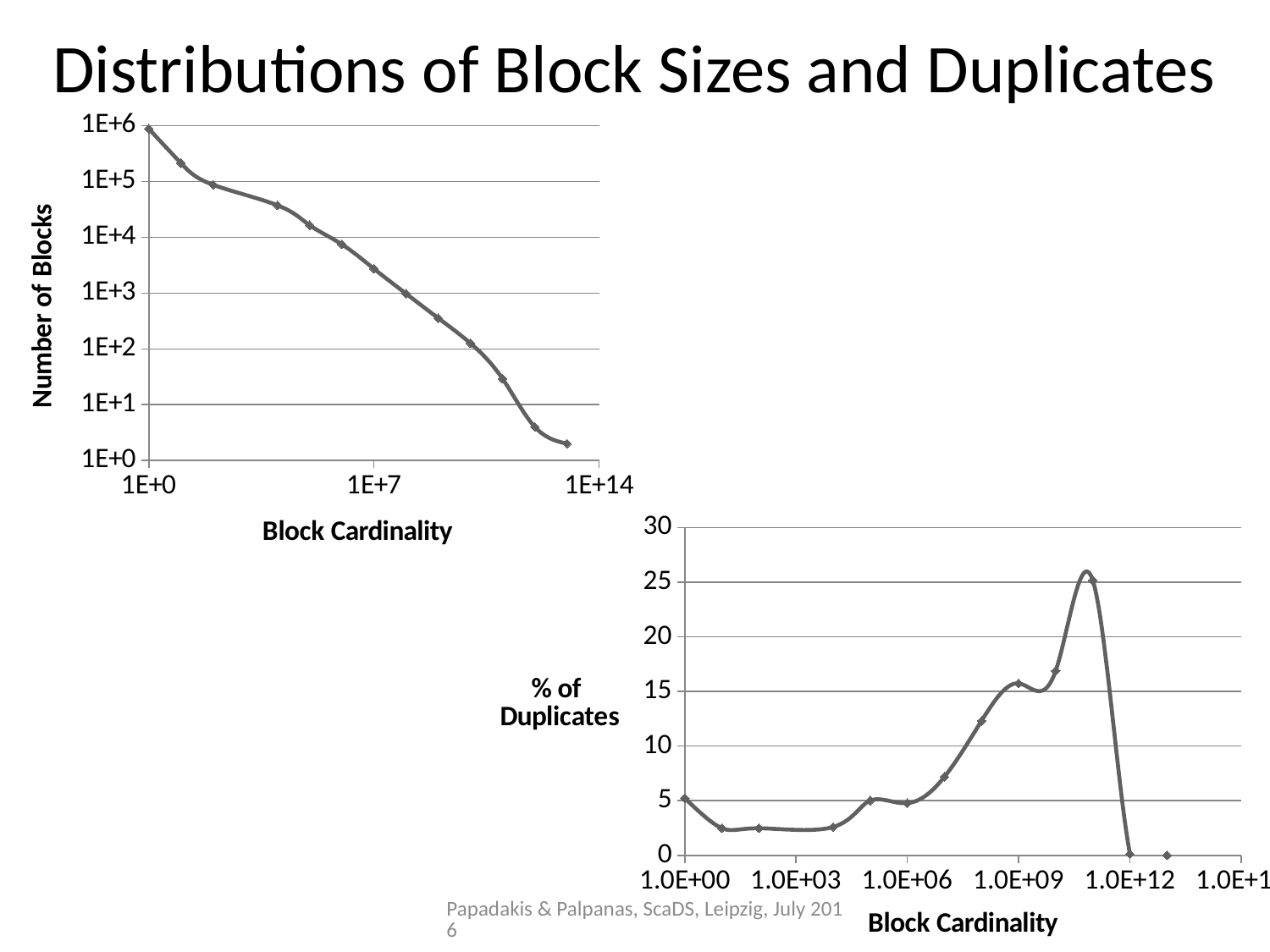
In the top-left chart, is the Number of Blocks at Block Cardinality 1E+7 greater or less than 1E+4? less In the top-left chart, does the Number of Blocks rise or fall as Block Cardinality increases? fall In the bottom-right chart, is the % of Duplicates at Block Cardinality 1.0E+09 greater or less than 10? greater In the bottom-right chart, is the highest % of Duplicates greater or less than 20? greater What kind of chart is the top-left chart showing Number of Blocks against Block Cardinality? line chart What kind of chart is the bottom-right chart showing % of Duplicates against Block Cardinality? line chart What is the y-axis title of the top-left chart? Number of Blocks In the bottom-right chart, what is the lowest % of Duplicates value reached? 0 What is the x-axis title shared by both charts? Block Cardinality